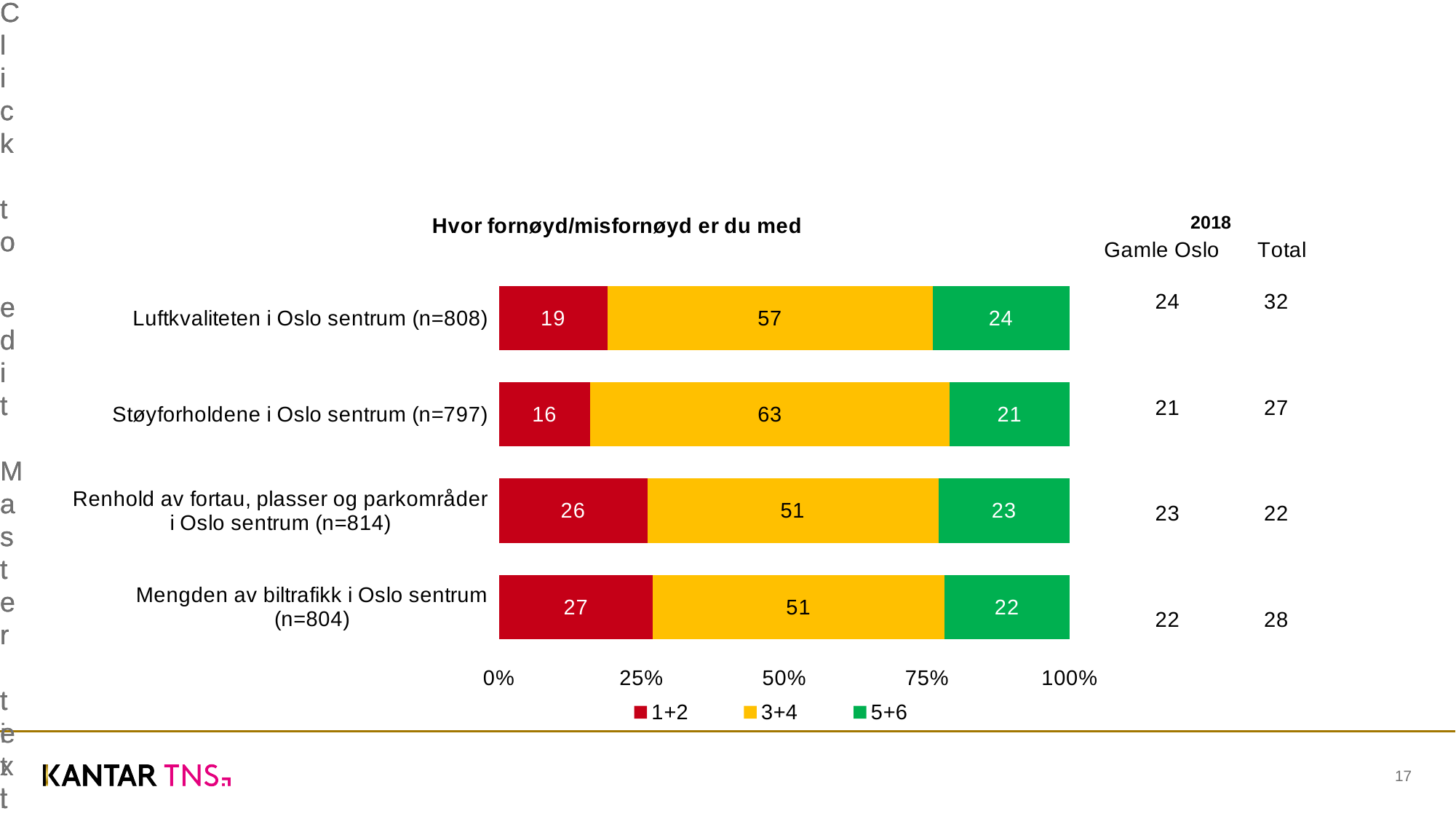
Which is larger: the 5+6 value for Luftkvaliteten i Oslo sentrum (n=808) or for Støyforholdene i Oslo sentrum (n=797)? Luftkvaliteten i Oslo sentrum (n=808) Which category has the highest value for the 1+2 series? Mengden av biltrafikk i Oslo sentrum (n=804) What is the difference between the 3+4 values for Støyforholdene i Oslo sentrum (n=797) and Luftkvaliteten i Oslo sentrum (n=808)? 6 What is the value of the 5+6 series for Mengden av biltrafikk i Oslo sentrum (n=804)? 22 Which category has the lowest value for the 3+4 series? Renhold av fortau, plasser og parkområder i Oslo sentrum (n=814) and Mengden av biltrafikk i Oslo sentrum (n=804) How many series does the legend list? 3 How many categories are plotted in the chart? 4 What kind of chart is shown on the slide? Stacked bar chart What is the title of the chart? Hvor fornøyd/misfornøyd er du med What is the value of the 1+2 series for Luftkvaliteten i Oslo sentrum (n=808)? 19 What is the total of the stacked bar for Renhold av fortau, plasser og parkområder i Oslo sentrum (n=814)? 100 What is the value of the 3+4 series for Støyforholdene i Oslo sentrum (n=797)? 63